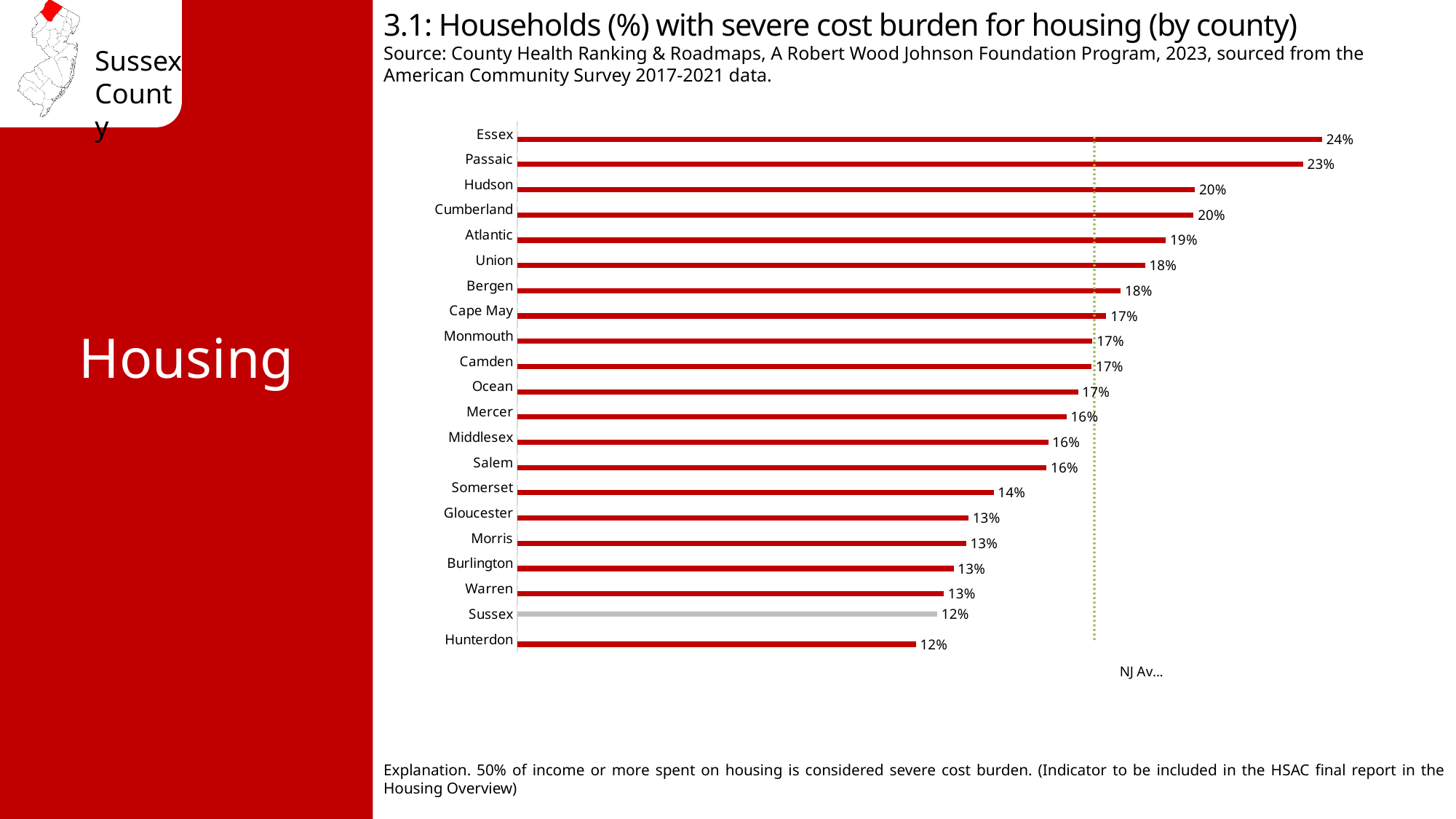
How many counties are shown in the chart? 21 What is the value for Somerset? 14% What is the value for Essex? 24% Which is larger, the value for Passaic or the value for Hudson? Passaic What is the value for Sussex? 12% What is the difference between the values for Essex and Sussex? 12 percentage points What kind of chart is shown on the slide? Bar chart What is the value for Atlantic? 19% Which county's bar is drawn in grey rather than red? Sussex Which is larger, the value for Gloucester or the value for Mercer? Mercer Which county has the highest value? Essex What is the difference between the values for Passaic and Somerset? 9 percentage points